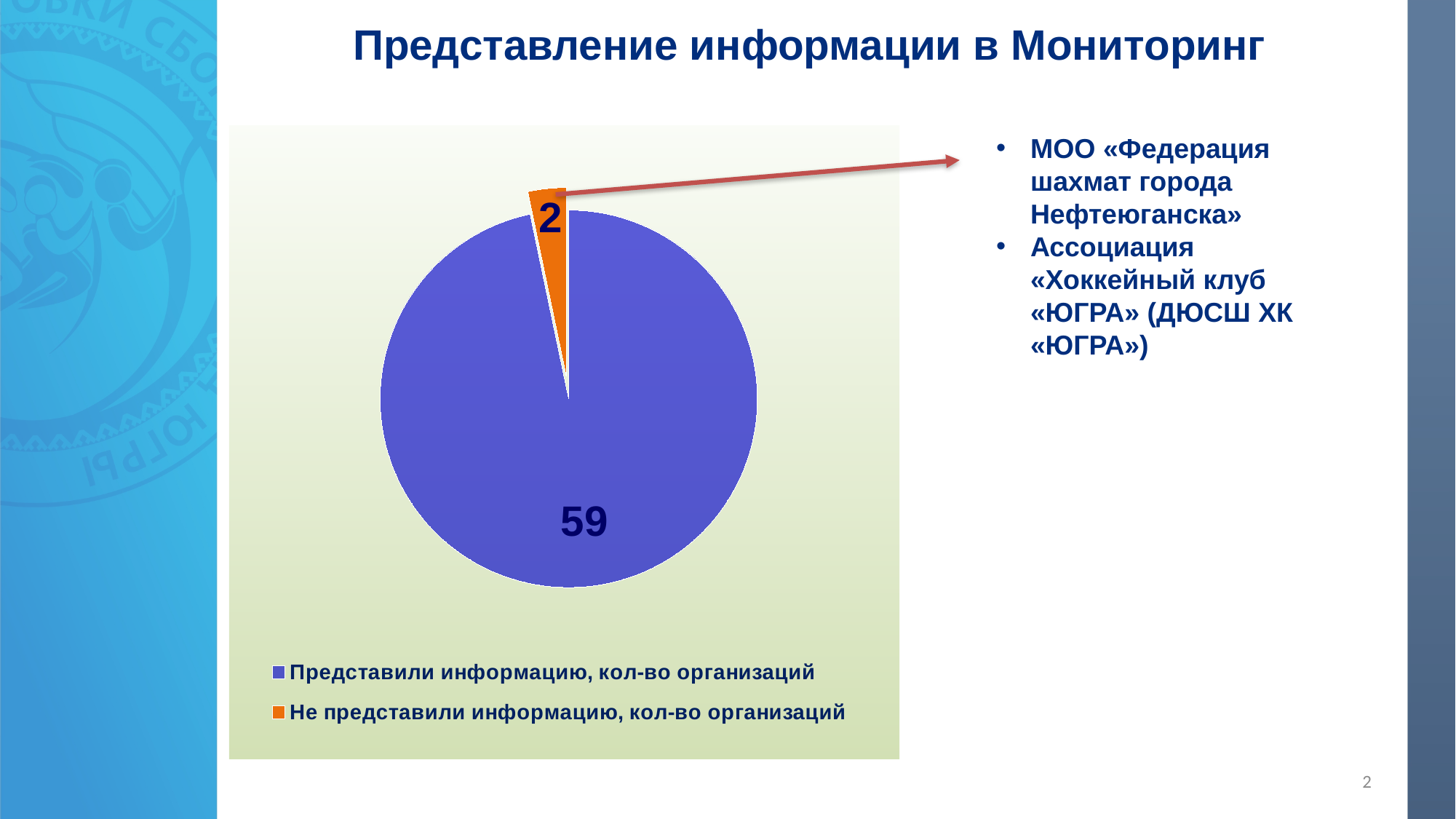
How many entries does the legend list? 2 What colour is the slice for "Не представили информацию, кол-во организаций"? orange What is the title of the slide containing the pie chart? Представление информации в Мониторинг Which slice of the pie chart is the smallest? Не представили информацию, кол-во организаций What is the total number of organisations represented in the pie chart? 61 How many organisations are in the "Представили информацию, кол-во организаций" slice? 59 How many slices does the pie chart have? 2 Which is larger: the number of organisations that provided information or the number that did not? Представили информацию, кол-во организаций How many organisations are in the "Не представили информацию, кол-во организаций" slice? 2 Which slice of the pie chart is the largest? Представили информацию, кол-во организаций What kind of chart is shown on the slide? pie chart What is the difference between the number of organisations that provided information and those that did not? 57